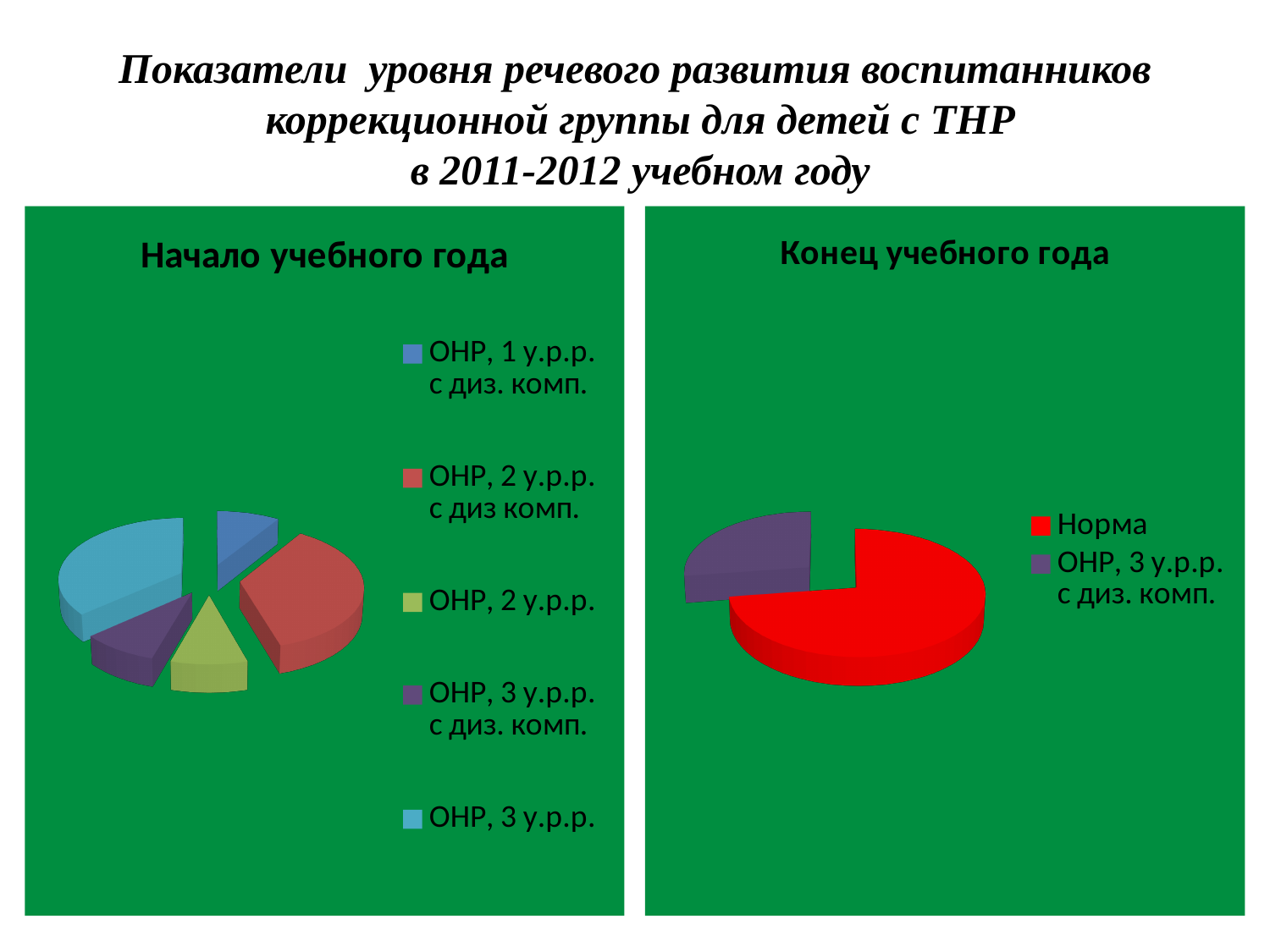
In the "Конец учебного года" chart, which slice is larger: "Норма" or "ОНР, 3 у.р.р. с диз. комп."? Норма What is the title of the pie chart on the left side of the slide? Начало учебного года In the "Начало учебного года" chart, which slice is larger: "ОНР, 3 у.р.р." or "ОНР, 1 у.р.р. с диз. комп."? ОНР, 3 у.р.р. In the "Конец учебного года" chart, which category has the largest slice? Норма In the "Конец учебного года" chart, which category has the smallest slice? ОНР, 3 у.р.р. с диз. комп. How many slices does the "Начало учебного года" pie chart have? 5 What kind of chart is the "Конец учебного года" chart? pie chart How many slices does the "Конец учебного года" pie chart have? 2 In the "Начало учебного года" chart, which slice is larger: "ОНР, 2 у.р.р. с диз комп." or "ОНР, 2 у.р.р."? ОНР, 2 у.р.р. с диз комп. What kind of chart is the "Начало учебного года" chart? pie chart What colour is the "Норма" slice in the "Конец учебного года" chart? red How many entries does the legend of the "Начало учебного года" chart list? 5